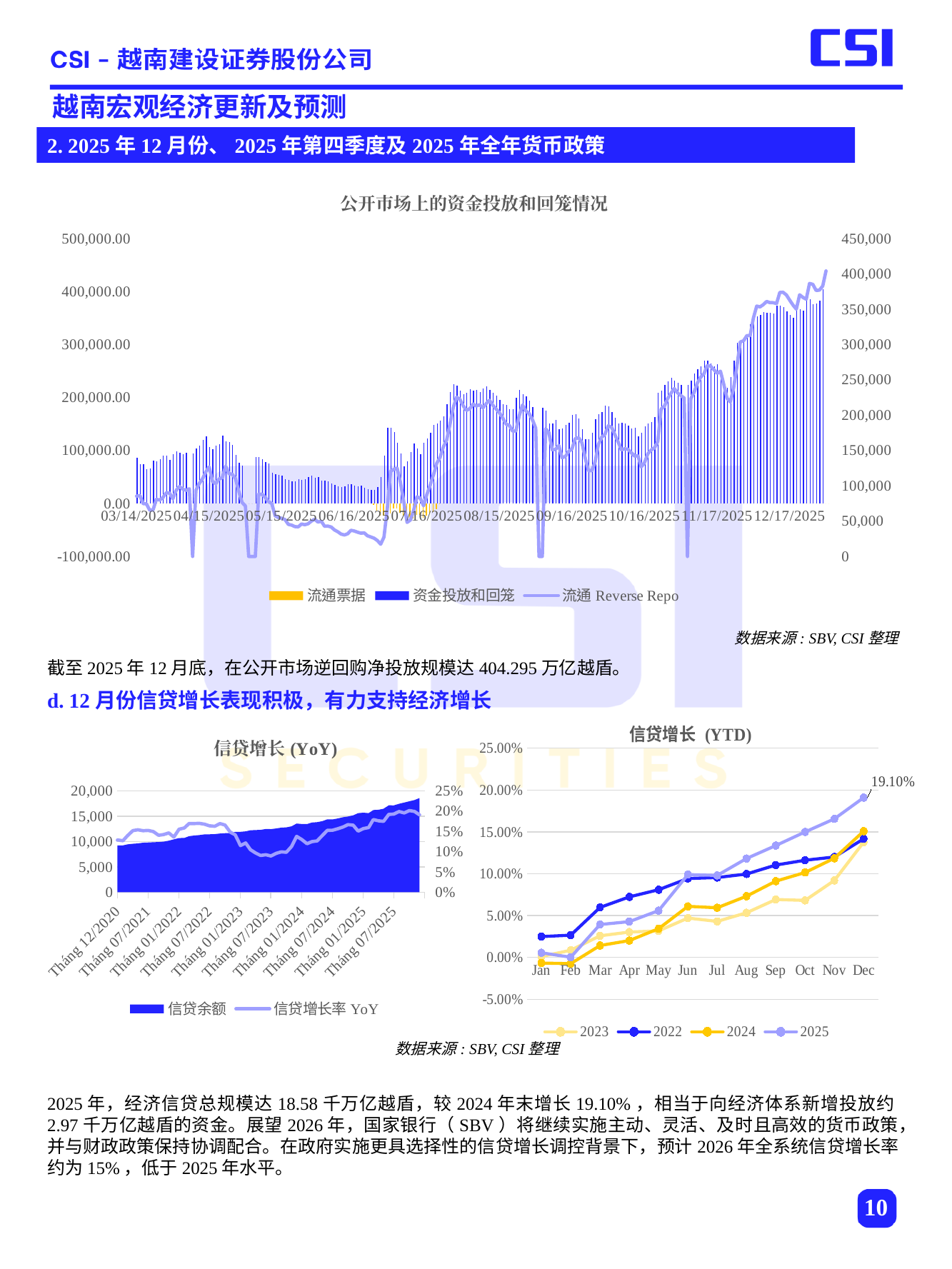
On the bottom-left chart titled 信贷增长 (YoY), does the 信贷余额 series rise or fall along the x axis? rise On the bottom-right chart titled 信贷增长 (YTD), how many months are shown on the x axis? 12 On the bottom-left chart titled 信贷增长 (YoY), how many series does the legend list? 2 On the bottom-right chart titled 信贷增长 (YTD), which series has the highest value in Jan? 2022 On the top chart titled 公开市场上的资金投放和回笼情况, how many series does the legend list? 3 On the bottom-right chart titled 信贷增长 (YTD), is the value for 2025 in Dec greater or less than 15.00%? greater On the bottom-right chart titled 信贷增长 (YTD), in Jun, which is larger: the value for 2025 or the value for 2024? 2025 On the bottom-right chart titled 信贷增长 (YTD), which series has the highest value in Dec? 2025 On the bottom-right chart titled 信贷增长 (YTD), does the 2025 series rise or fall from Jan to Dec? rise What kind of chart is the top chart titled 公开市场上的资金投放和回笼情况? Combination bar and line chart On the bottom-right chart titled 信贷增长 (YTD), how many series does the legend list? 4 On the bottom-right chart titled 信贷增长 (YTD), what is the value for 2025 in Dec? 19.10%